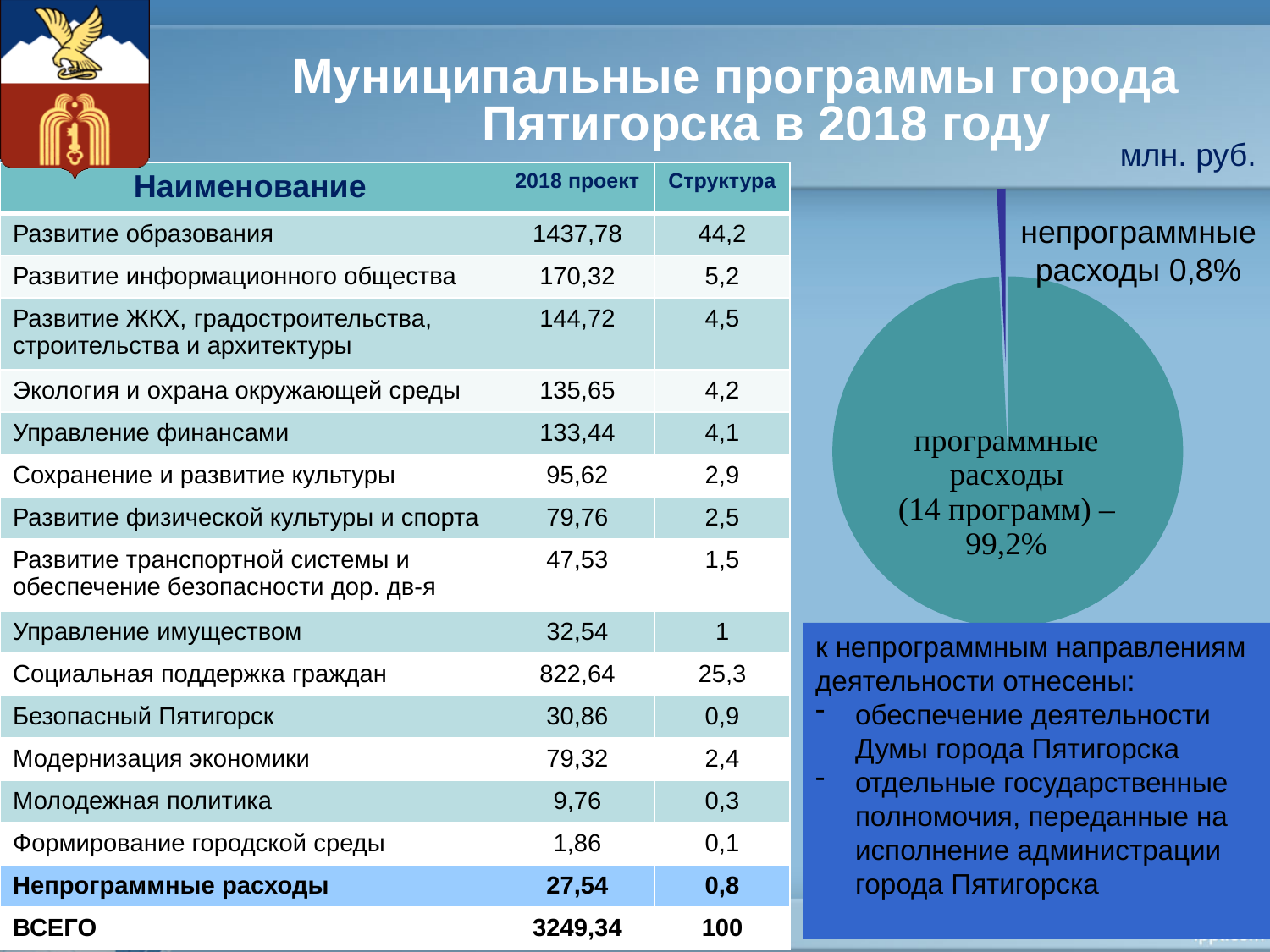
What unit is indicated above the pie chart? млн. руб. By how many percentage points does the share of программные расходы exceed the share of непрограммные расходы in the pie chart? 98,4 According to the pie chart label, how many programs make up программные расходы? 14 Which slice of the pie chart is the smallest? непрограммные расходы What is the combined share of the two slices in the pie chart? 100% What share of the pie chart is taken by непрограммные расходы? 0,8% How many slices does the pie chart have? 2 What share of the pie chart is taken by программные расходы? 99,2% Which slice of the pie chart is the largest? программные расходы In the pie chart, which is larger: программные расходы or непрограммные расходы? программные расходы What kind of chart is shown on the right side of the slide? pie chart